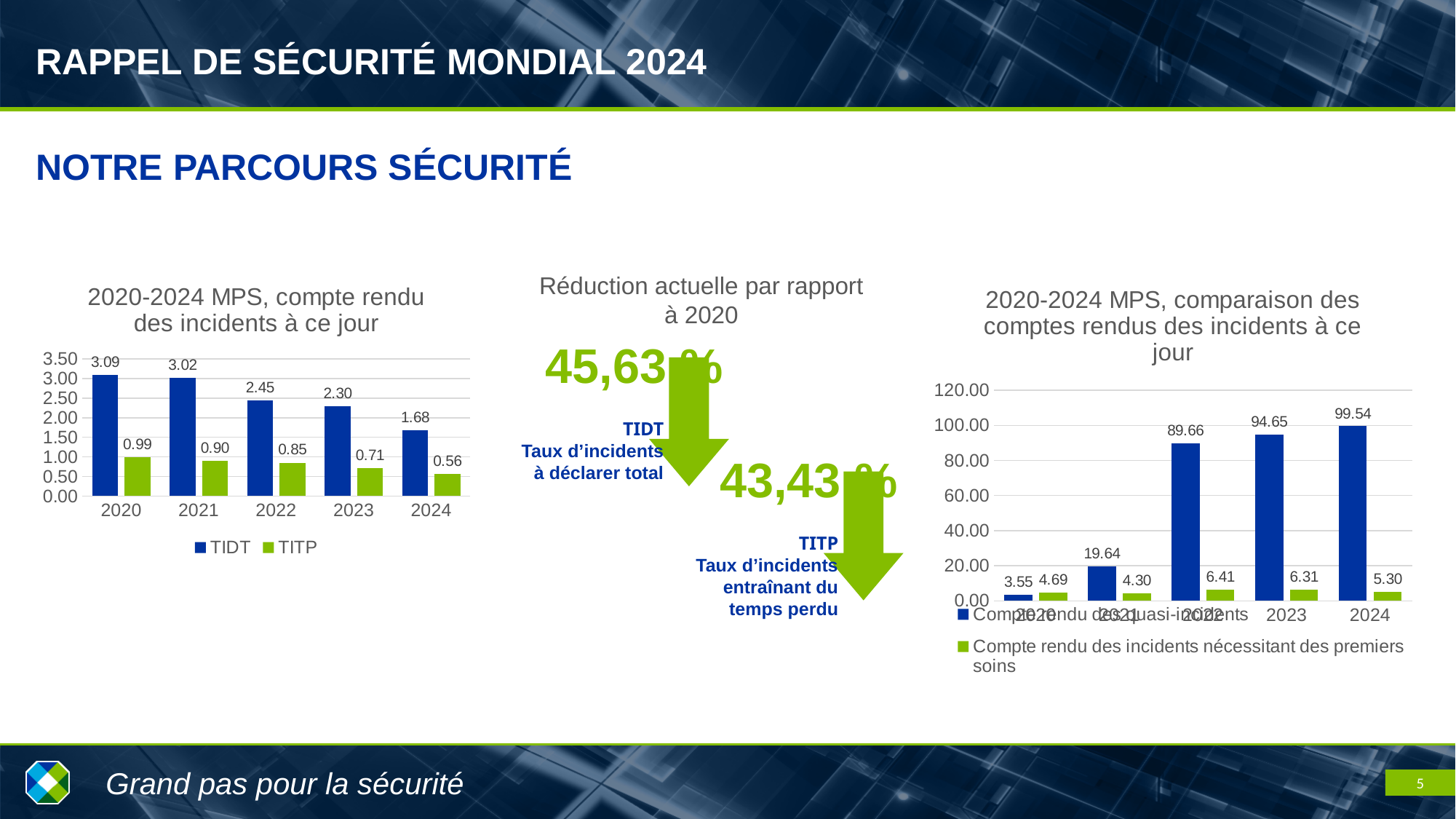
In the left chart '2020-2024 MPS, compte rendu des incidents à ce jour', what is the difference between the TIDT values for 2020 and 2024? 1.41 What kind of chart is the right chart '2020-2024 MPS, comparaison des comptes rendus des incidents à ce jour'? bar chart In the left chart '2020-2024 MPS, compte rendu des incidents à ce jour', which year has the lowest TIDT value? 2024 In the left chart '2020-2024 MPS, compte rendu des incidents à ce jour', do the TITP values rise or fall from 2020 to 2024? fall In the left chart '2020-2024 MPS, compte rendu des incidents à ce jour', what is the TITP value for 2024? 0.56 In the left chart '2020-2024 MPS, compte rendu des incidents à ce jour', how many series does the legend list? 2 In the right chart '2020-2024 MPS, comparaison des comptes rendus des incidents à ce jour', what is the value for 'Compte rendu des quasi-incidents' in 2024? 99.54 In the left chart '2020-2024 MPS, compte rendu des incidents à ce jour', what is the TIDT value for 2020? 3.09 In the right chart '2020-2024 MPS, comparaison des comptes rendus des incidents à ce jour', which is larger in 2020: 'Compte rendu des quasi-incidents' or 'Compte rendu des incidents nécessitant des premiers soins'? Compte rendu des incidents nécessitant des premiers soins In the right chart '2020-2024 MPS, comparaison des comptes rendus des incidents à ce jour', how many years are shown on the x axis? 5 In the right chart '2020-2024 MPS, comparaison des comptes rendus des incidents à ce jour', which year has the highest value for 'Compte rendu des quasi-incidents'? 2024 In the right chart '2020-2024 MPS, comparaison des comptes rendus des incidents à ce jour', what is the value for 'Compte rendu des incidents nécessitant des premiers soins' in 2022? 6.41